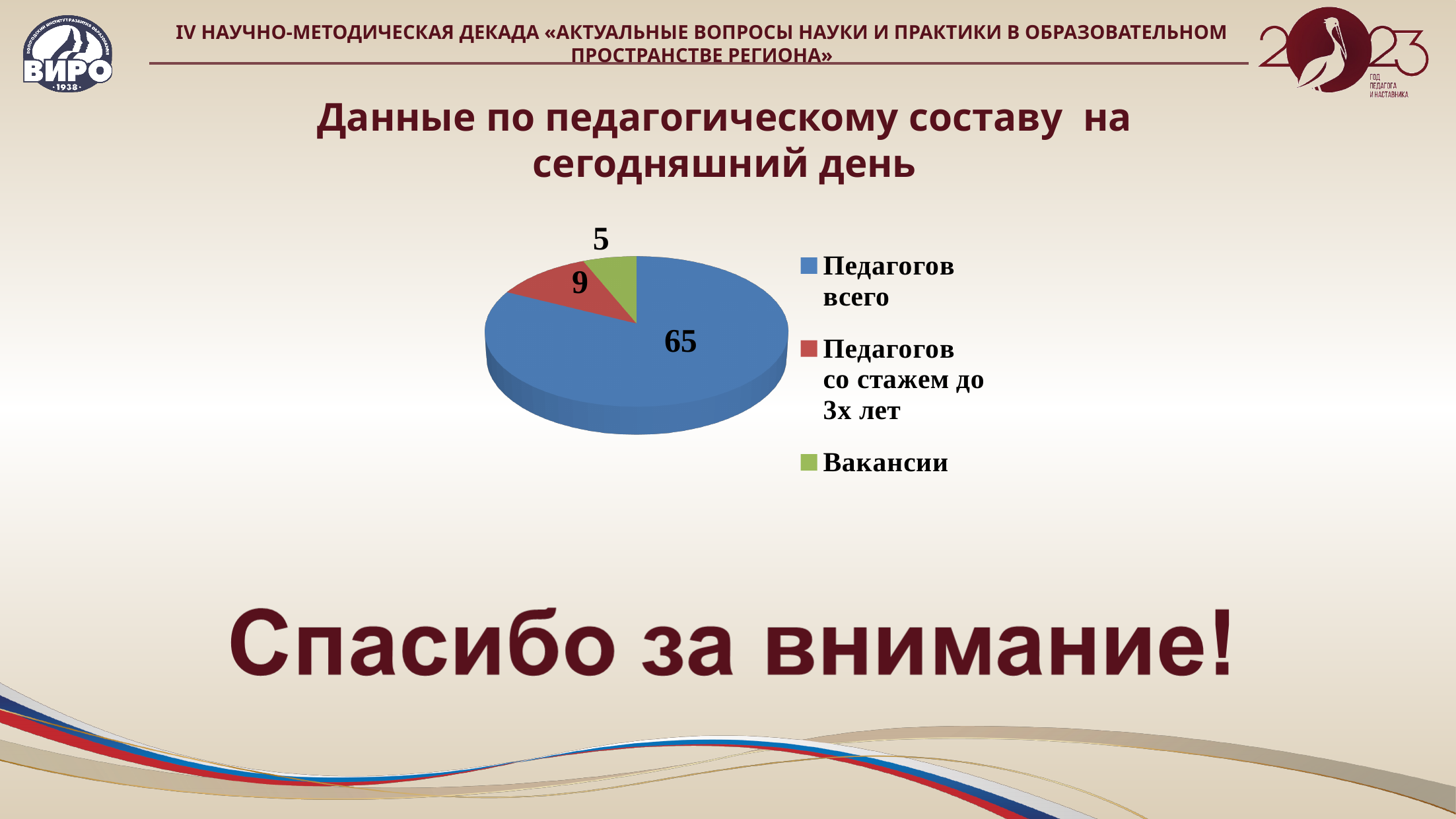
What is the difference between the values for Педагогов со стажем до 3х лет and Вакансии? 4 What is the difference between the values for Педагогов всего and Педагогов со стажем до 3х лет? 56 What colour is the slice for Вакансии? green What is the value for Вакансии? 5 What is the value for Педагогов со стажем до 3х лет? 9 What is the value for Педагогов всего? 65 Which is larger, the value for Педагогов со стажем до 3х лет or the value for Вакансии? Педагогов со стажем до 3х лет What is the total of all values shown in the pie chart? 79 Which category has the smallest slice of the pie? Вакансии How many slices does the pie chart have? 3 What type of chart is shown on the slide? pie chart Which category has the largest slice of the pie? Педагогов всего